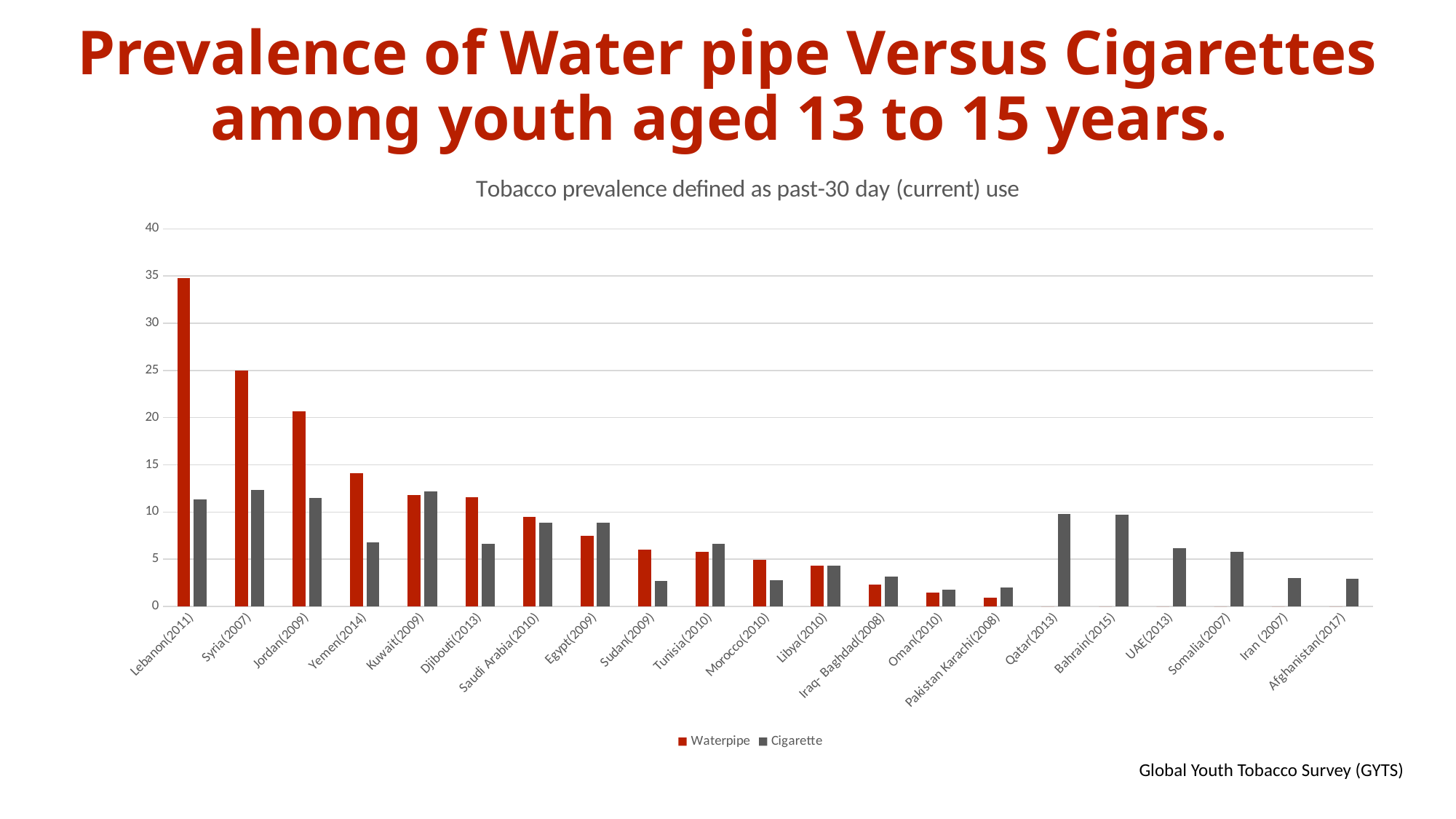
Is the Cigarette value for Lebanon(2011) greater or less than 10? greater Which colour represents the Waterpipe series in the legend? Red How many countries (categories) are shown on the x axis? 21 Is the Cigarette value for Sudan(2009) greater or less than 5? less Is the Waterpipe value for Lebanon(2011) greater or less than 30? greater Which country has the highest Waterpipe prevalence? Lebanon(2011) What kind of chart is shown on the slide? Bar chart Do the Waterpipe values rise or fall moving from Lebanon(2011) to Pakistan Karachi(2008) along the x axis? Fall For Yemen(2014), which is larger: the Waterpipe value or the Cigarette value? Waterpipe How many series does the legend list? 2 For Egypt(2009), which is larger: the Waterpipe value or the Cigarette value? Cigarette